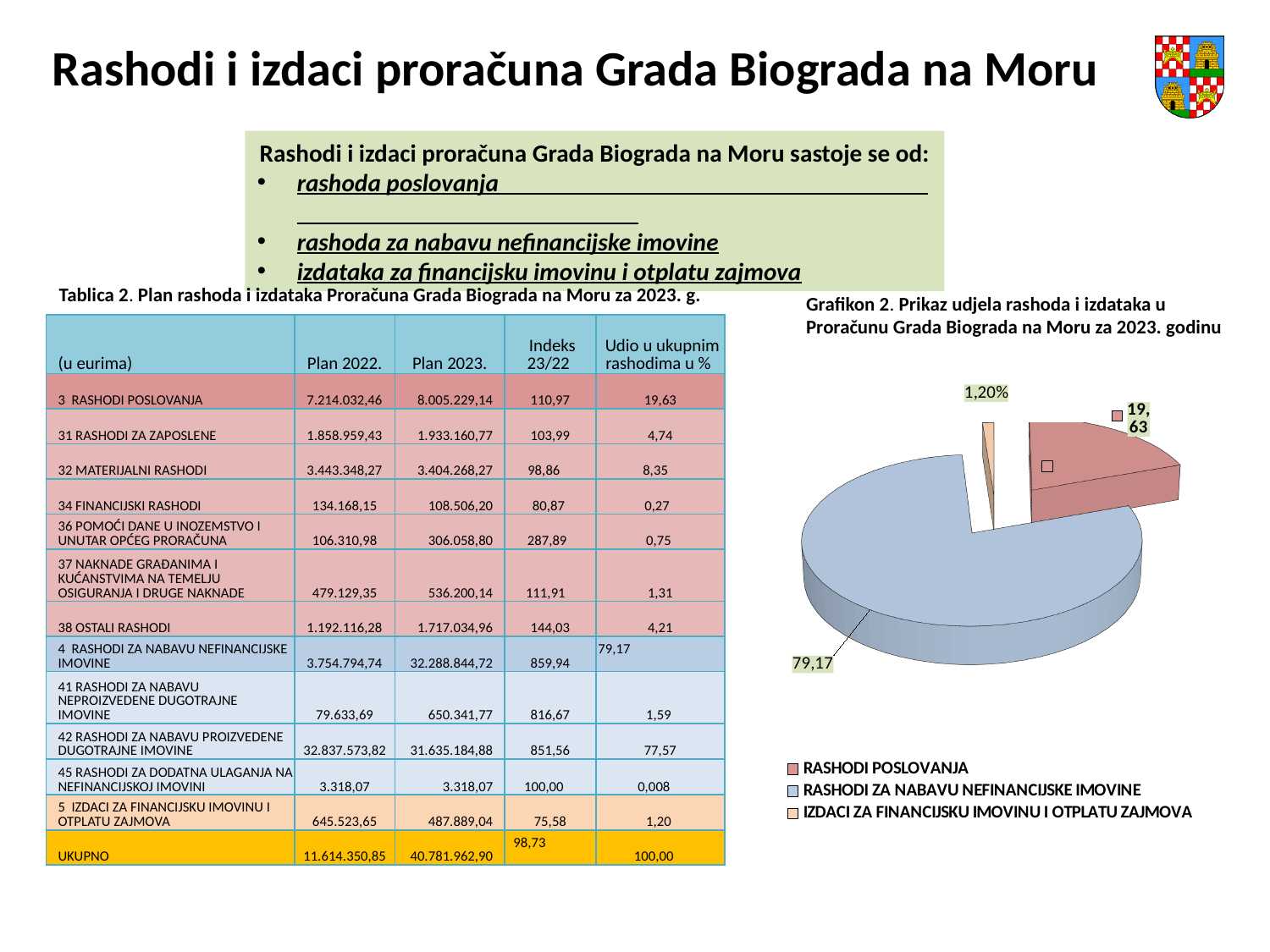
Which category has the largest slice in the pie chart? RASHODI ZA NABAVU NEFINANCIJSKE IMOVINE What value is shown for RASHODI POSLOVANJA in the pie chart? 19,63 Which is larger in the pie chart: RASHODI POSLOVANJA or IZDACI ZA FINANCIJSKU IMOVINU I OTPLATU ZAJMOVA? RASHODI POSLOVANJA Which category has the smallest slice in the pie chart? IZDACI ZA FINANCIJSKU IMOVINU I OTPLATU ZAJMOVA What kind of chart is shown on the slide? Pie chart What is the title of the pie chart? Grafikon 2. Prikaz udjela rashoda i izdataka u Proračunu Grada Biograda na Moru za 2023. godinu What value is shown for IZDACI ZA FINANCIJSKU IMOVINU I OTPLATU ZAJMOVA in the pie chart? 1,20% How many slices does the pie chart have? 3 What value is shown for RASHODI ZA NABAVU NEFINANCIJSKE IMOVINE in the pie chart? 79,17 Which colour represents RASHODI POSLOVANJA in the pie chart? Red (pink) What is the difference between the values for RASHODI ZA NABAVU NEFINANCIJSKE IMOVINE and RASHODI POSLOVANJA in the pie chart? 59,54 How many entries does the legend of the pie chart list? 3